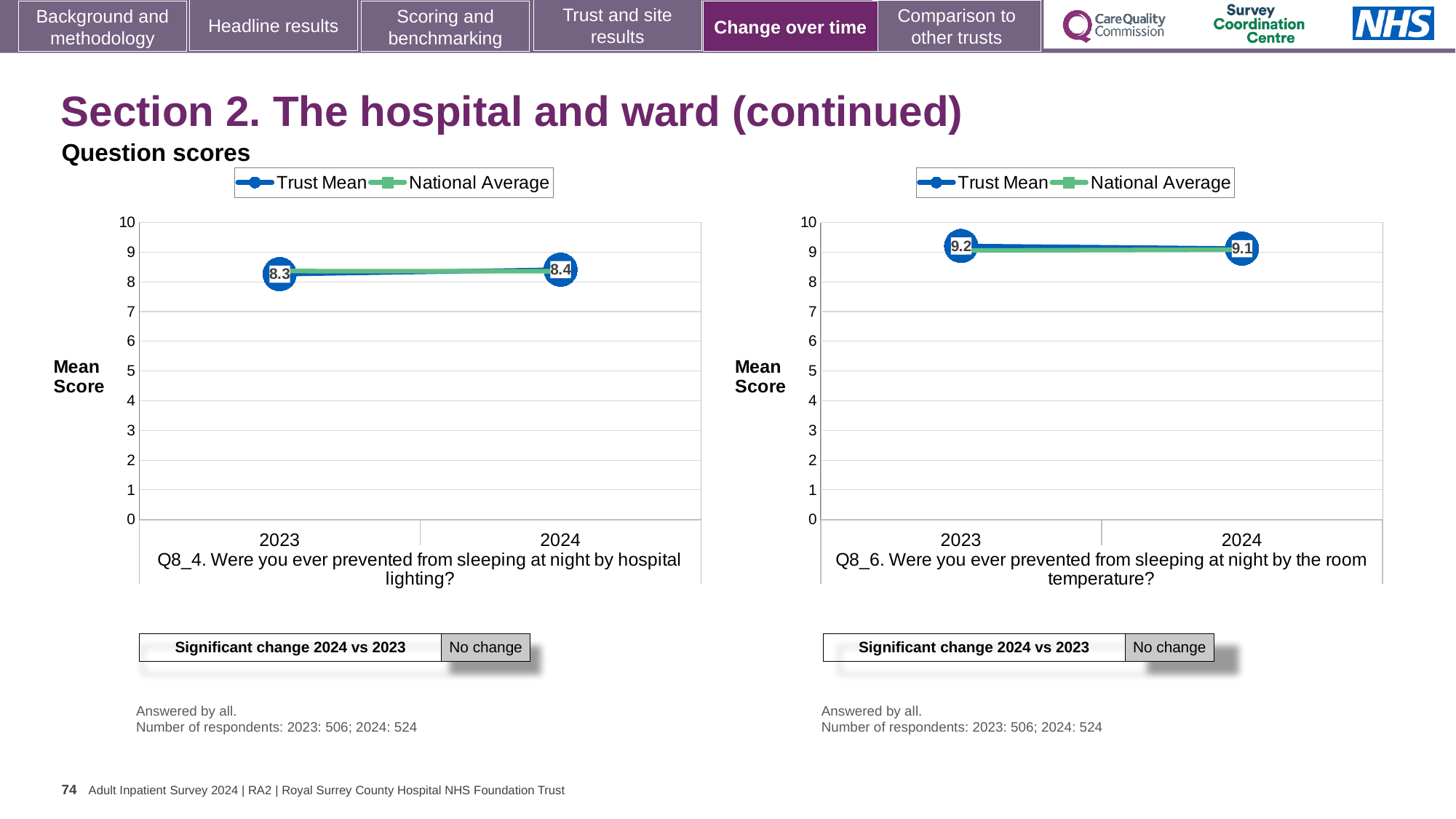
In the left chart (Q8_4, hospital lighting), does the Trust Mean rise or fall from 2023 to 2024? rise What kind of chart is the right chart (Q8_6, room temperature)? line chart In the left chart (Q8_4, hospital lighting), what is the difference between the Trust Mean scores for 2024 and 2023? 0.1 In the right chart (Q8_6, room temperature), what is the Trust Mean score for 2023? 9.2 In the right chart (Q8_6, room temperature), does the Trust Mean rise or fall from 2023 to 2024? fall How many series does the legend of the left chart (Q8_4, hospital lighting) list? 2 In the left chart (Q8_4, hospital lighting), is the Trust Mean for 2024 greater or less than 9? less How many years are plotted on the x axis of the left chart (Q8_4, hospital lighting)? 2 In the left chart (Q8_4, hospital lighting), what is the Trust Mean score for 2023? 8.3 In the left chart (Q8_4, hospital lighting), what is the Trust Mean score for 2024? 8.4 In the right chart (Q8_6, room temperature), is the Trust Mean for 2023 greater or less than 9? greater In the right chart (Q8_6, room temperature), what is the Trust Mean score for 2024? 9.1